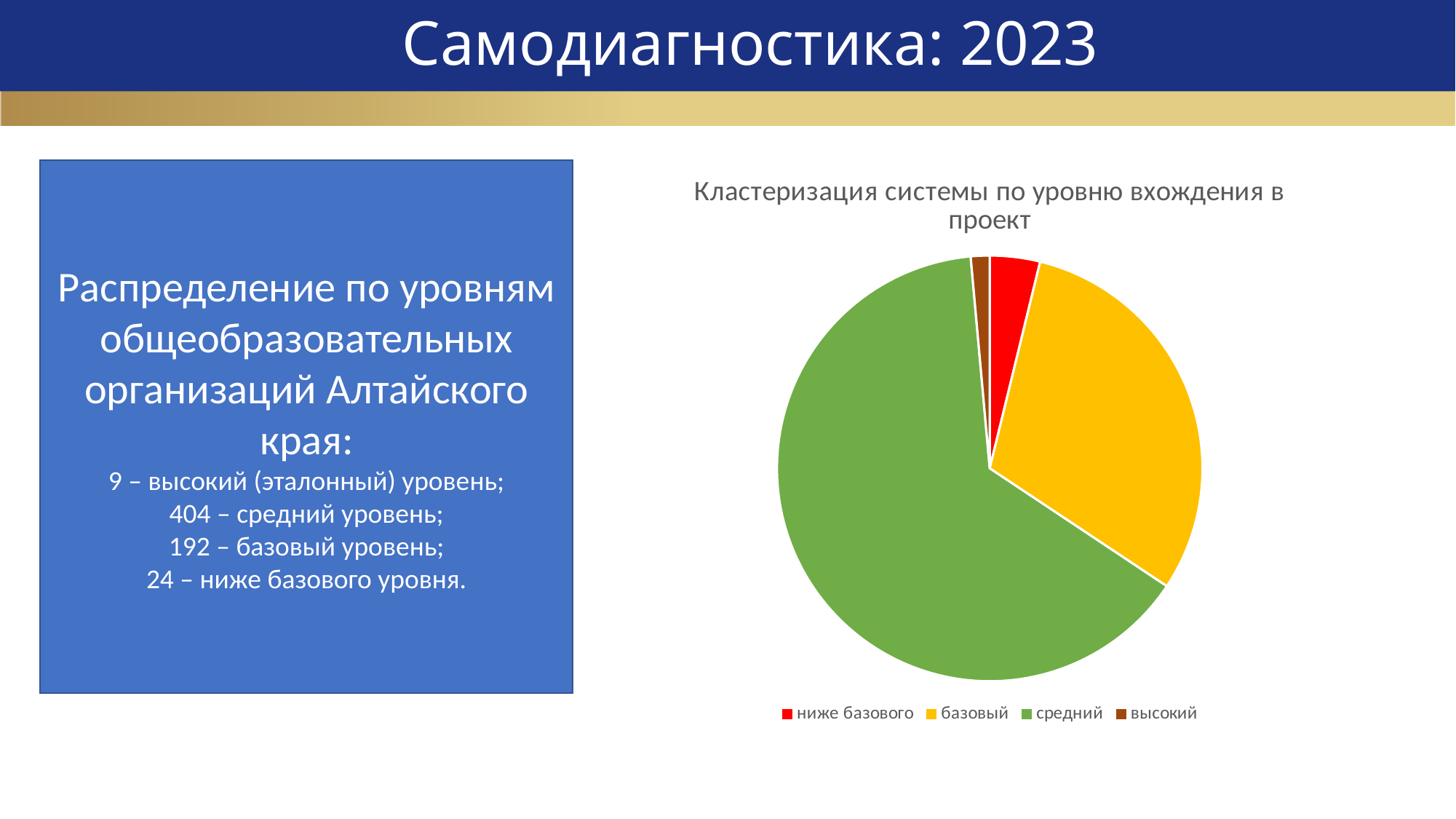
How many slices does the pie chart have? 4 What colour is the slice for средний in the pie chart? green According to the slide, how many organisations are at the средний уровень? 404 Which category has the smallest slice in the pie chart? высокий What kind of chart is shown on the slide? pie chart What is the title of the pie chart? Кластеризация системы по уровню вхождения в проект Which category has the largest slice in the pie chart? средний Which slice is larger in the pie chart: ниже базового or высокий? ниже базового Which slice is larger in the pie chart: базовый or ниже базового? базовый According to the slide, how many organisations are at the высокий (эталонный) уровень? 9 How many entries does the legend of the pie chart list? 4 According to the slide, how many organisations are at the базовый уровень? 192